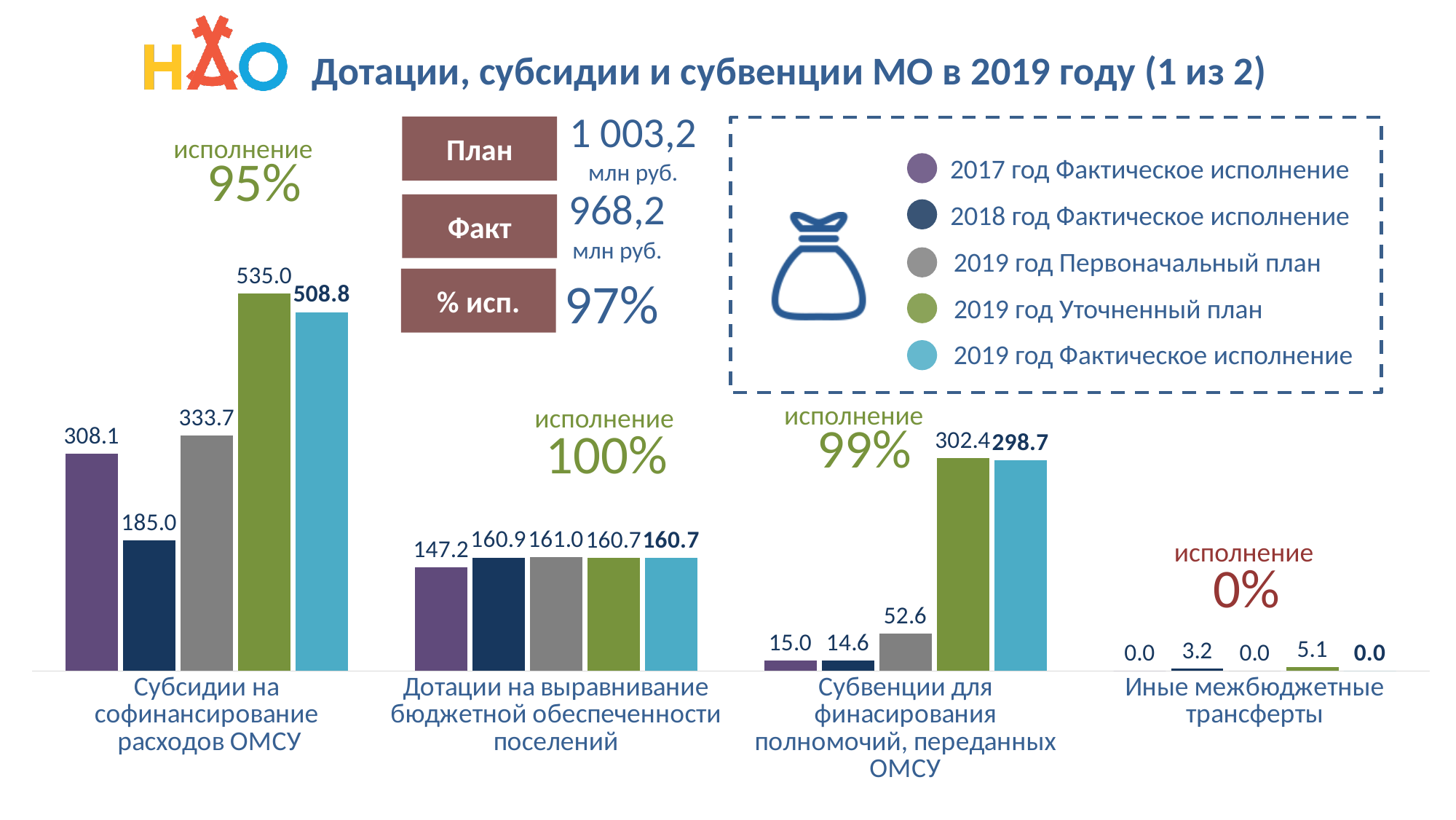
Which category has the highest value in the 2019 год Уточненный план series? Субсидии на софинансирование расходов ОМСУ What is the value of the 2019 год Первоначальный план series for Субвенции для финасирования полномочий, переданных ОМСУ? 52.6 How many series does the legend list? 5 What kind of chart is shown on the slide? Bar chart Which category has the lowest value in the 2017 год Фактическое исполнение series? Иные межбюджетные трансферты Which is larger for Субвенции для финасирования полномочий, переданных ОМСУ: the 2017 год Фактическое исполнение value or the 2019 год Первоначальный план value? 2019 год Первоначальный план What is the value of the 2017 год Фактическое исполнение series for Дотации на выравнивание бюджетной обеспеченности поселений? 147.2 What is the value of the 2018 год Фактическое исполнение series for Иные межбюджетные трансферты? 3.2 What is the difference between the 2019 год Уточненный план and 2019 год Фактическое исполнение values for Субсидии на софинансирование расходов ОМСУ? 26.2 How many categories are shown on the x axis of the chart? 4 What is the value of the 2019 год Фактическое исполнение series for Субсидии на софинансирование расходов ОМСУ? 508.8 What colour represents the 2019 год Фактическое исполнение series in the legend? Light blue